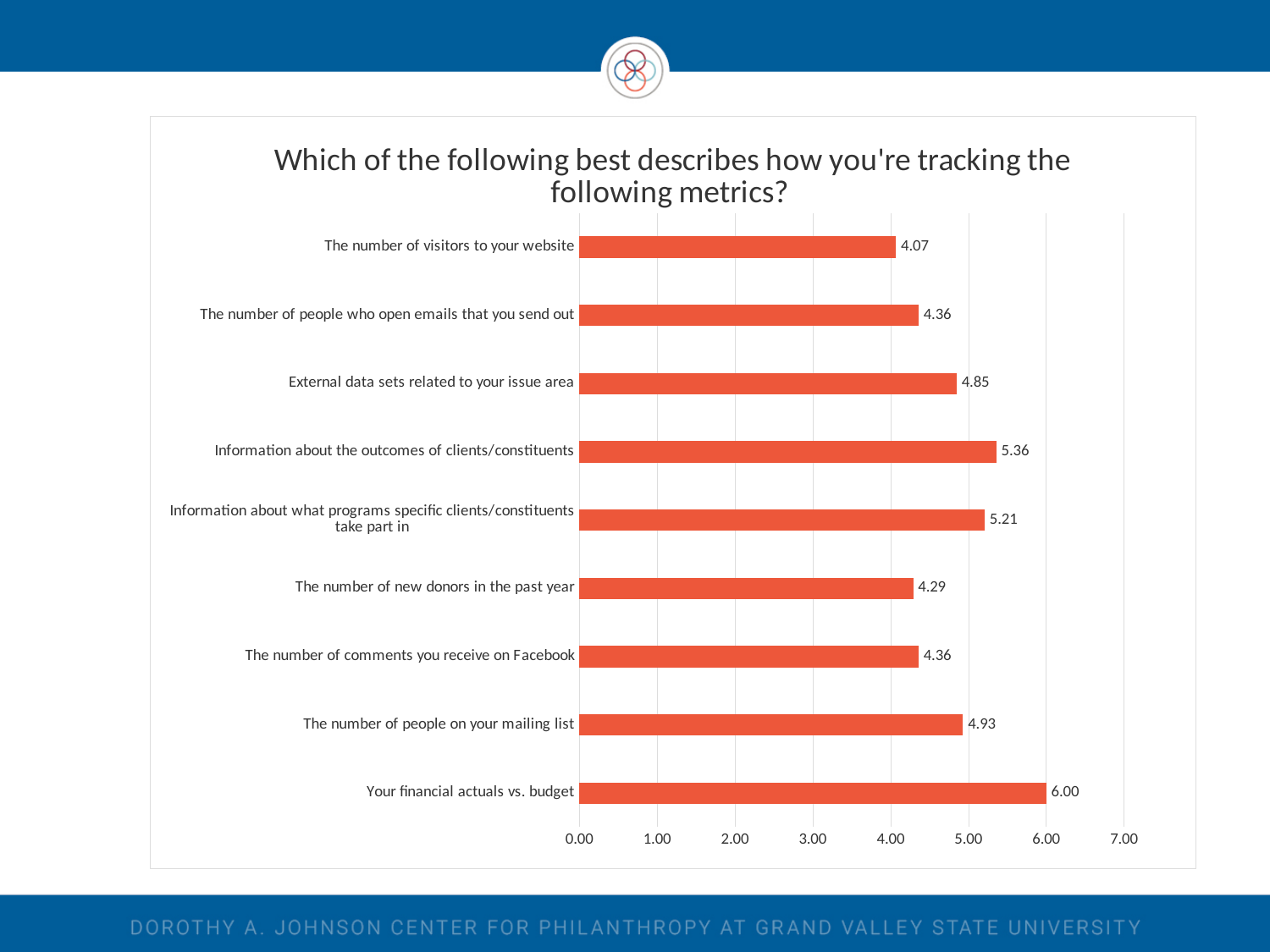
What is the value for 'Information about the outcomes of clients/constituents'? 5.36 What is the difference between the values for 'Your financial actuals vs. budget' and 'The number of visitors to your website'? 1.93 Which category has the highest value? Your financial actuals vs. budget What is the value for 'Your financial actuals vs. budget'? 6.00 What is the difference between the values for 'Information about the outcomes of clients/constituents' and 'Information about what programs specific clients/constituents take part in'? 0.15 What kind of chart is shown on the slide? Bar chart What is the value for 'The number of visitors to your website'? 4.07 Which is larger: the value for 'The number of people on your mailing list' or the value for 'The number of new donors in the past year'? The number of people on your mailing list Which category has the lowest value? The number of visitors to your website What is the title of the chart? Which of the following best describes how you're tracking the following metrics? What is the value for 'External data sets related to your issue area'? 4.85 How many categories are shown in the chart? 9